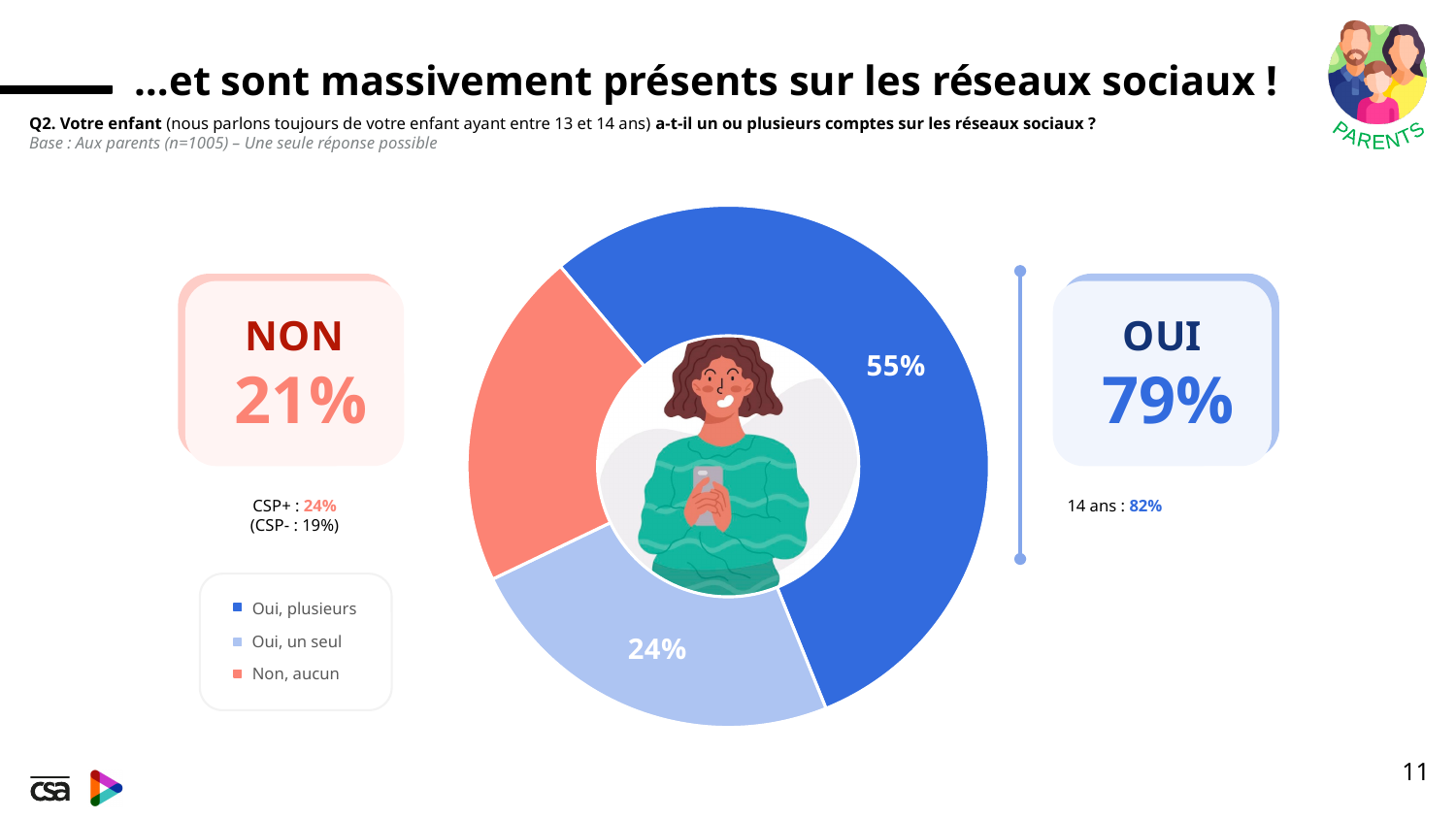
What share of the donut chart is labelled "Oui, plusieurs"? 55% What share of the donut chart corresponds to "Oui, un seul"? 24% What percentage is given for 14-year-olds ("14 ans") under the OUI box? 82% What is the difference in percentage points between the "Oui, plusieurs" slice (55%) and the "Oui, un seul" slice (24%)? 31 Which legend category has the largest slice of the donut chart? Oui, plusieurs What is the combined share of the two "Oui" slices (55% and 24%)? 79% How many entries does the legend of the chart list? 3 What kind of chart is shown on the slide? Donut (pie) chart Which slice is larger: "Oui, un seul" or "Non, aucun"? Oui, un seul Which legend category has the smallest slice of the donut chart? Non, aucun What percentage is shown in the OUI box on the right of the slide? 79% What percentage is shown in the NON box on the left of the slide? 21%